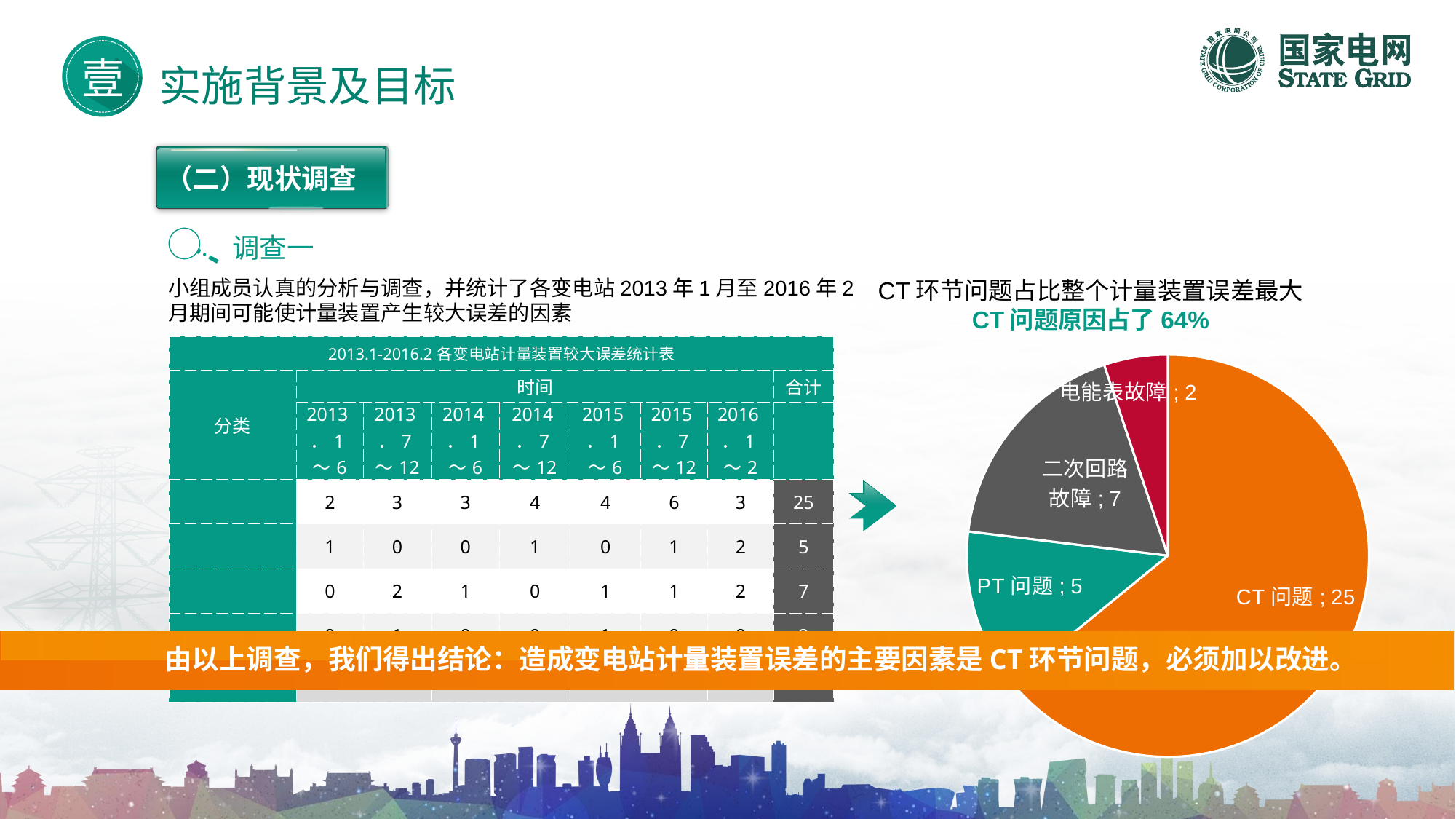
What share of the pie does CT 问题 account for, as stated on the slide? 64% What is the value for PT 问题 in the pie chart? 5 Which category has the largest slice in the pie chart? CT 问题 What kind of chart is shown on the right of the slide? pie chart What colour is the CT 问题 slice in the pie chart? orange What is the difference between the values for CT 问题 and 二次回路故障 in the pie chart? 18 Which category has the smallest slice in the pie chart? 电能表故障 How many slices does the pie chart have? 4 What is the value for 二次回路故障 in the pie chart? 7 What is the value for CT 问题 in the pie chart? 25 Which is larger in the pie chart, PT 问题 or 二次回路故障? 二次回路故障 What is the value for 电能表故障 in the pie chart? 2